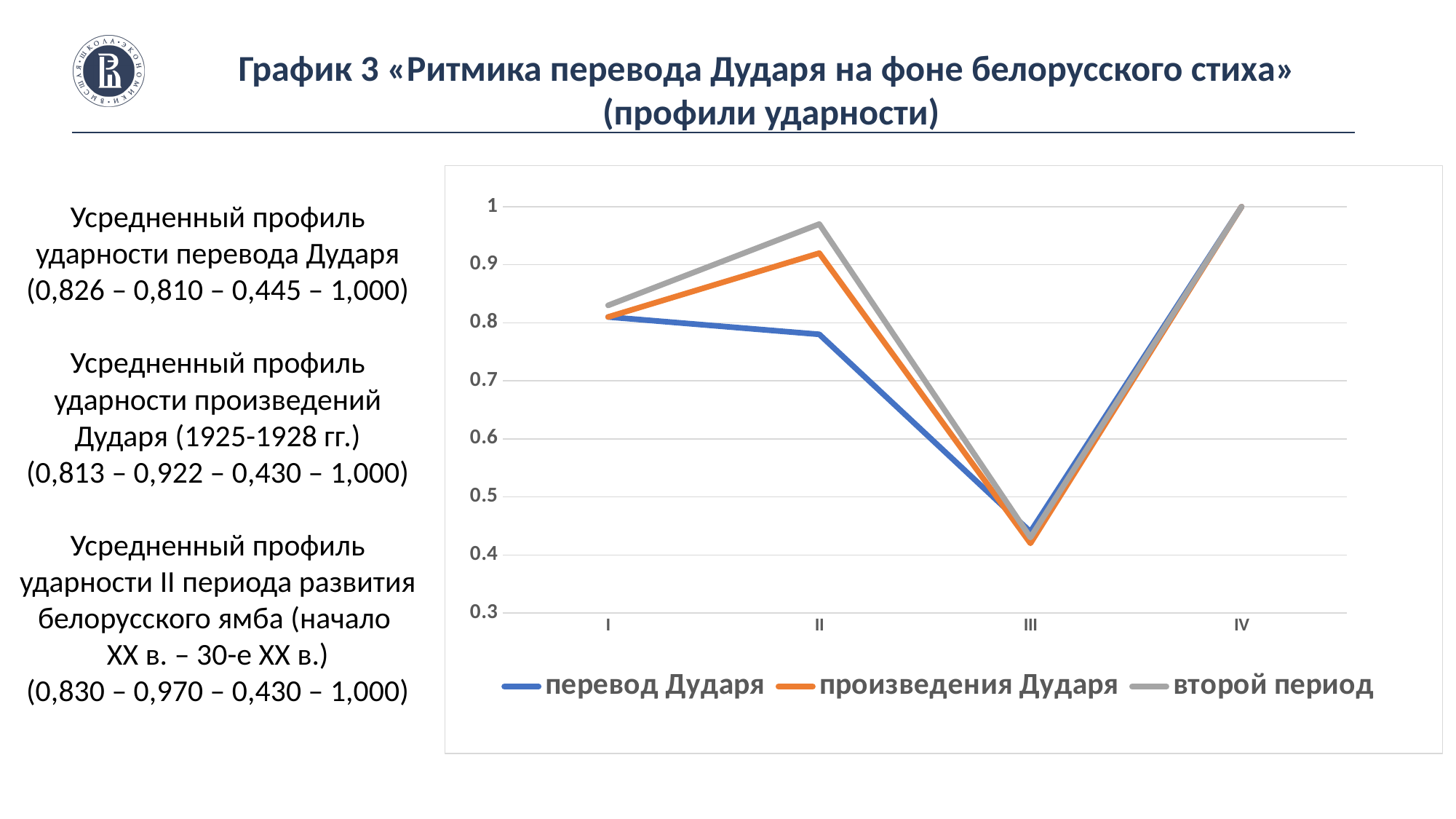
What is the value of the 'перевод Дударя' series at position IV? 1 Is the value of 'произведения Дударя' at position III greater or less than 0.5? less At which position does the 'произведения Дударя' series reach its highest value? IV What type of chart is shown on the slide? line chart Is the value of 'второй период' at position II greater or less than 0.9? greater Is the value of 'перевод Дударя' at position II greater or less than 0.8? less At which position does the 'второй период' series reach its lowest value? III Does the 'перевод Дударя' series rise or fall from position II to position III? fall What colour is the line for 'произведения Дударя' in the chart? orange At position II, which series has the higher value: 'перевод Дударя' or 'второй период'? второй период How many series does the legend of the chart list? 3 How many positions are plotted along the x axis of the chart? 4